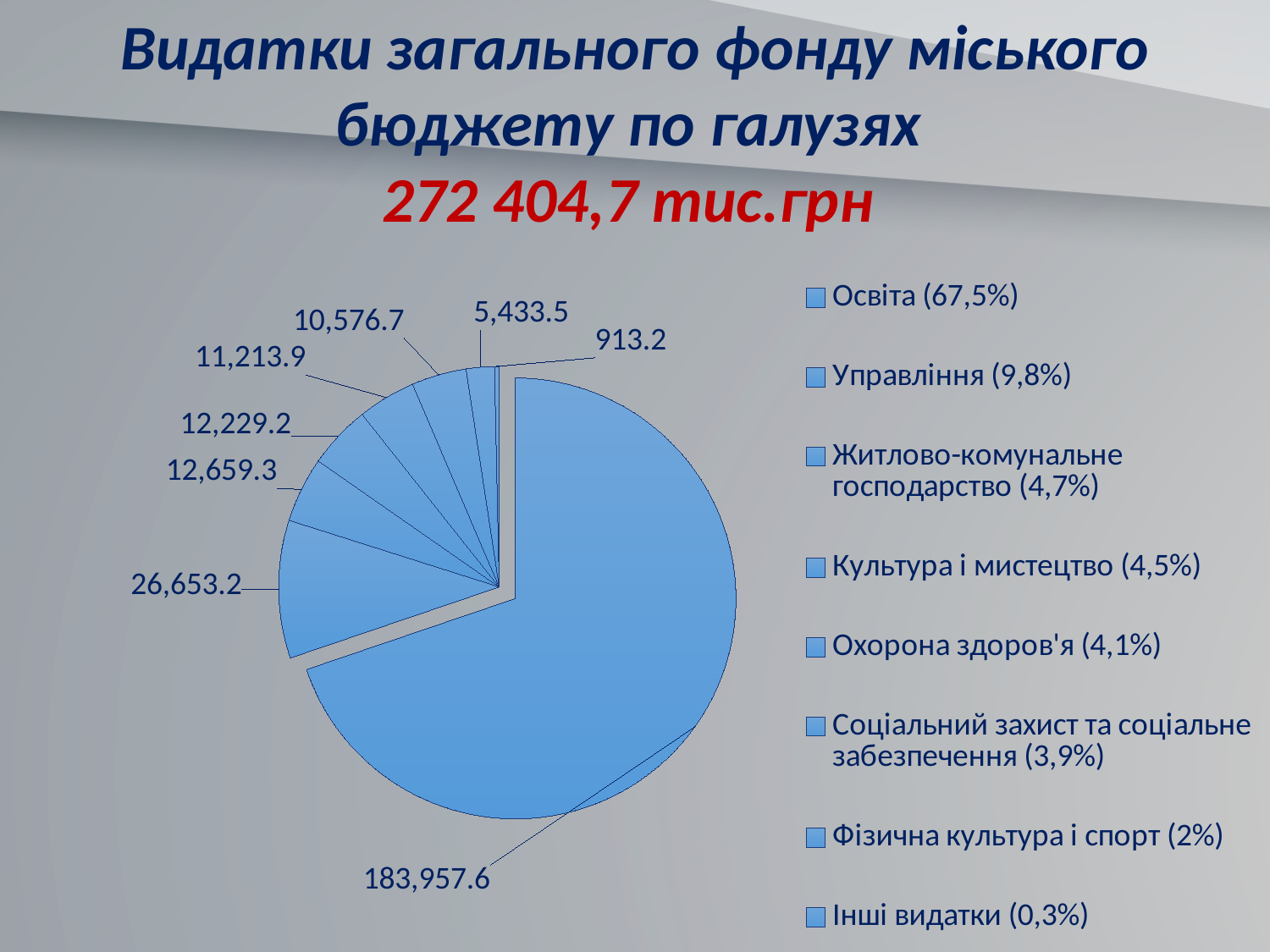
Which category has the smallest share of the pie chart? Інші видатки What is the value of the Управління slice? 26,653.2 What total amount is stated in the slide title? 272 404,7 тис.грн What share of the pie does Управління account for, according to the legend? 9,8% What is the value of the smallest slice of the pie chart? 913.2 What is the value of the largest slice of the pie chart? 183,957.6 Which category has the largest share of the pie chart? Освіта Which is larger: the slice labelled 12,659.3 or the slice labelled 5,433.5? 12,659.3 What share of the pie does Освіта account for, according to the legend? 67,5% What is the difference between the largest slice (183,957.6) and the second-largest slice (26,653.2)? 157,304.4 What kind of chart is shown on the slide? pie chart How many categories does the legend of the pie chart list? 8